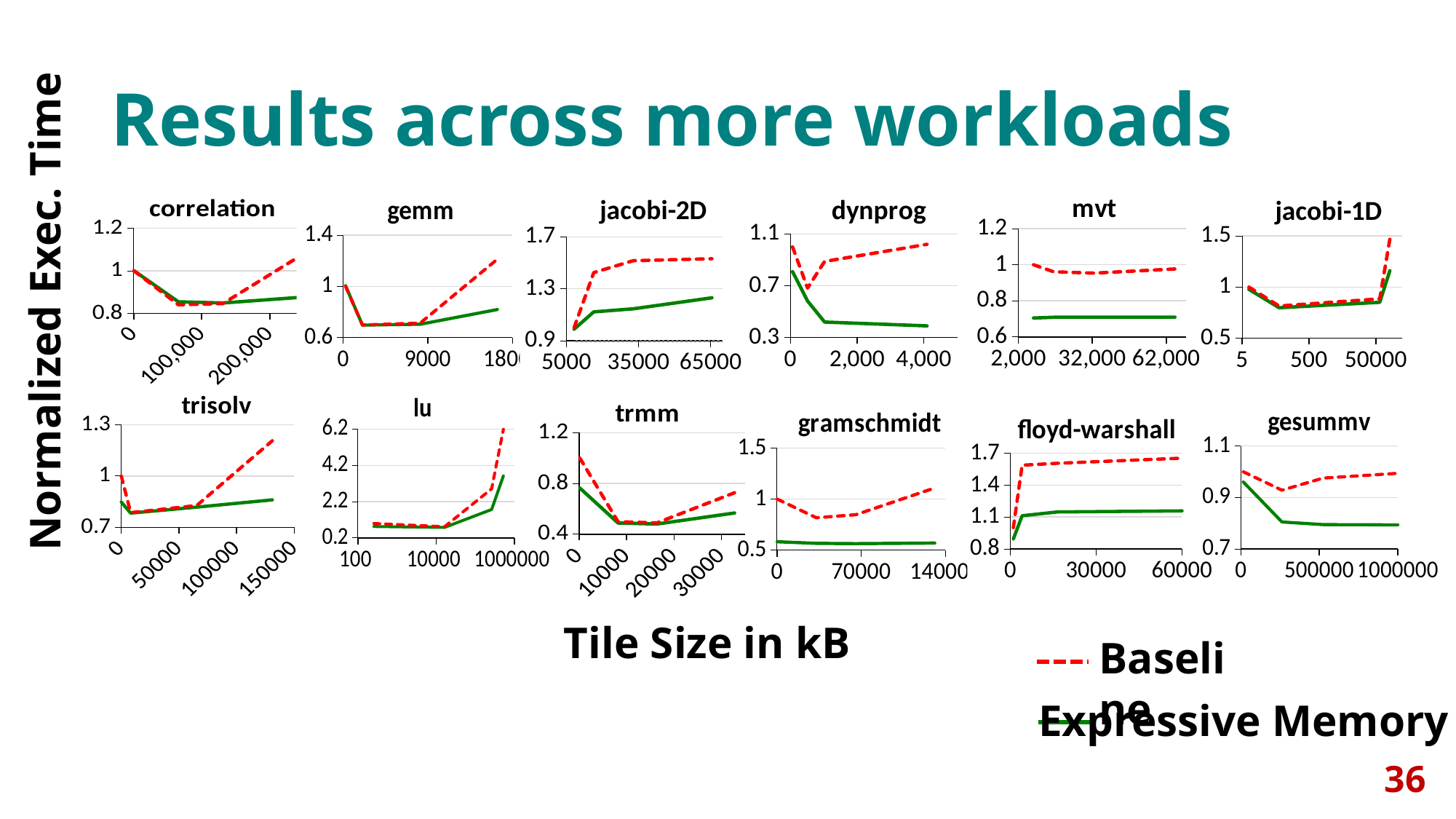
In the 'mvt' chart, which series has the higher value at tile size 32,000? Baseline In the 'gesummv' chart, does the Expressive Memory line rise or fall as tile size increases? falls In the 'jacobi-2D' chart, is the Baseline value at tile size 65000 greater or less than 1.3? greater In the 'lu' chart, is the Baseline value at the largest tile size greater or less than 4.2? greater How many small charts are shown on the slide? 12 What is the shared y-axis label for the charts? Normalized Exec. Time What kind of chart is the 'gemm' chart? Line chart How many series does the legend list? 2 What is the shared x-axis label for the charts? Tile Size in kB In the 'dynprog' chart, is the Expressive Memory value at tile size 4,000 greater or less than 0.7? less In the 'gramschmidt' chart, which series has the higher value at the largest tile size? Baseline In the 'floyd-warshall' chart, does the Baseline line rise or fall from tile size 0 to 60000? rises